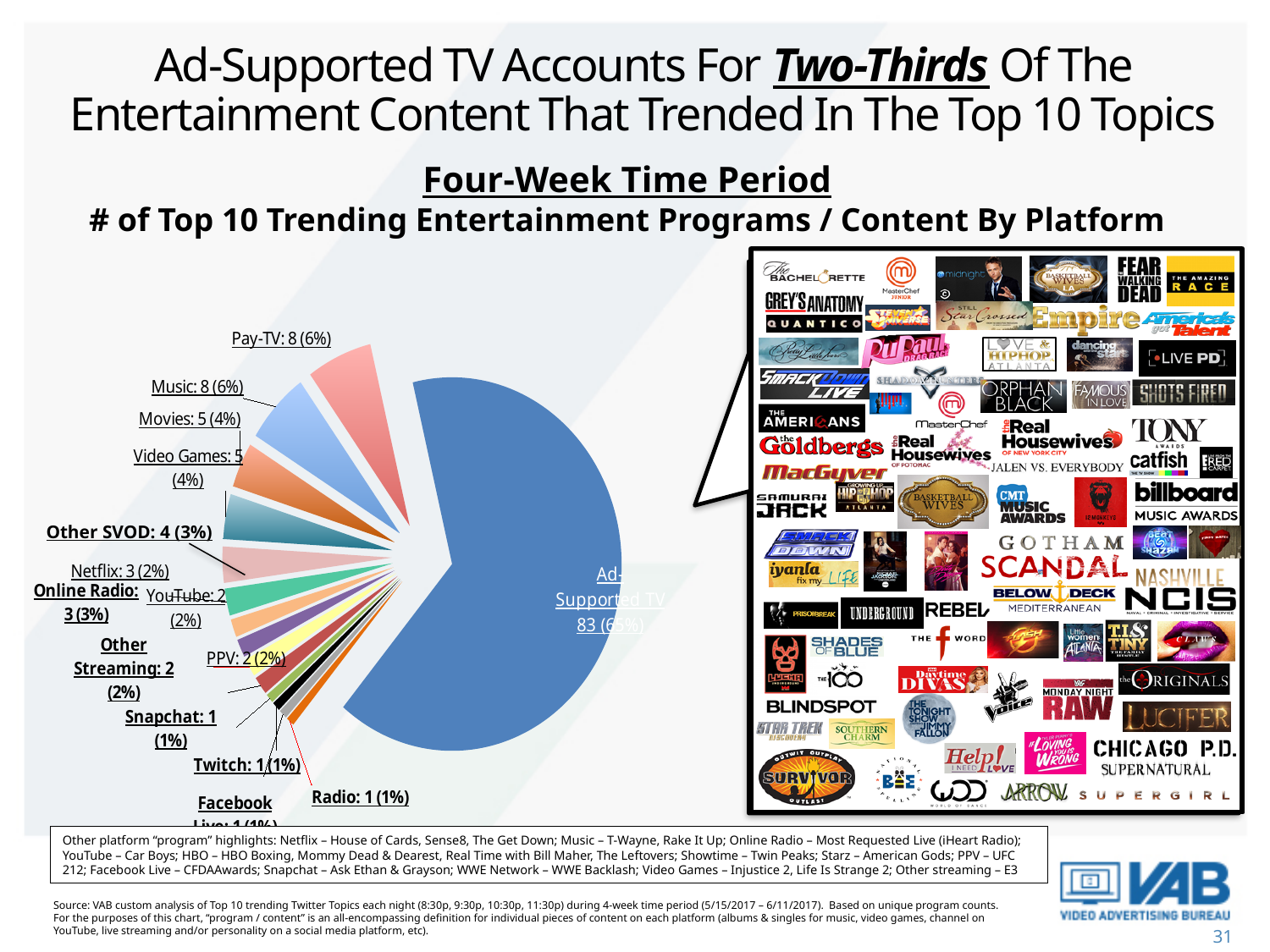
What kind of chart is shown on the slide? pie chart How many platform categories are shown in the pie chart? 15 What percentage share is shown for Other SVOD? 3% What time period does the chart subtitle say the data covers? Four-Week Time Period How many programs are attributed to Pay-TV? 8 Which has more programs, Music or Video Games? Music How many top 10 trending entertainment programs are attributed to Ad-Supported TV? 83 How many programs are attributed to Netflix? 3 What is the value shown for Movies? 5 (4%) What share of the pie does Ad-Supported TV account for? 65% What is the difference in program count between Ad-Supported TV and Pay-TV? 75 Which platform has the largest slice of the pie? Ad-Supported TV